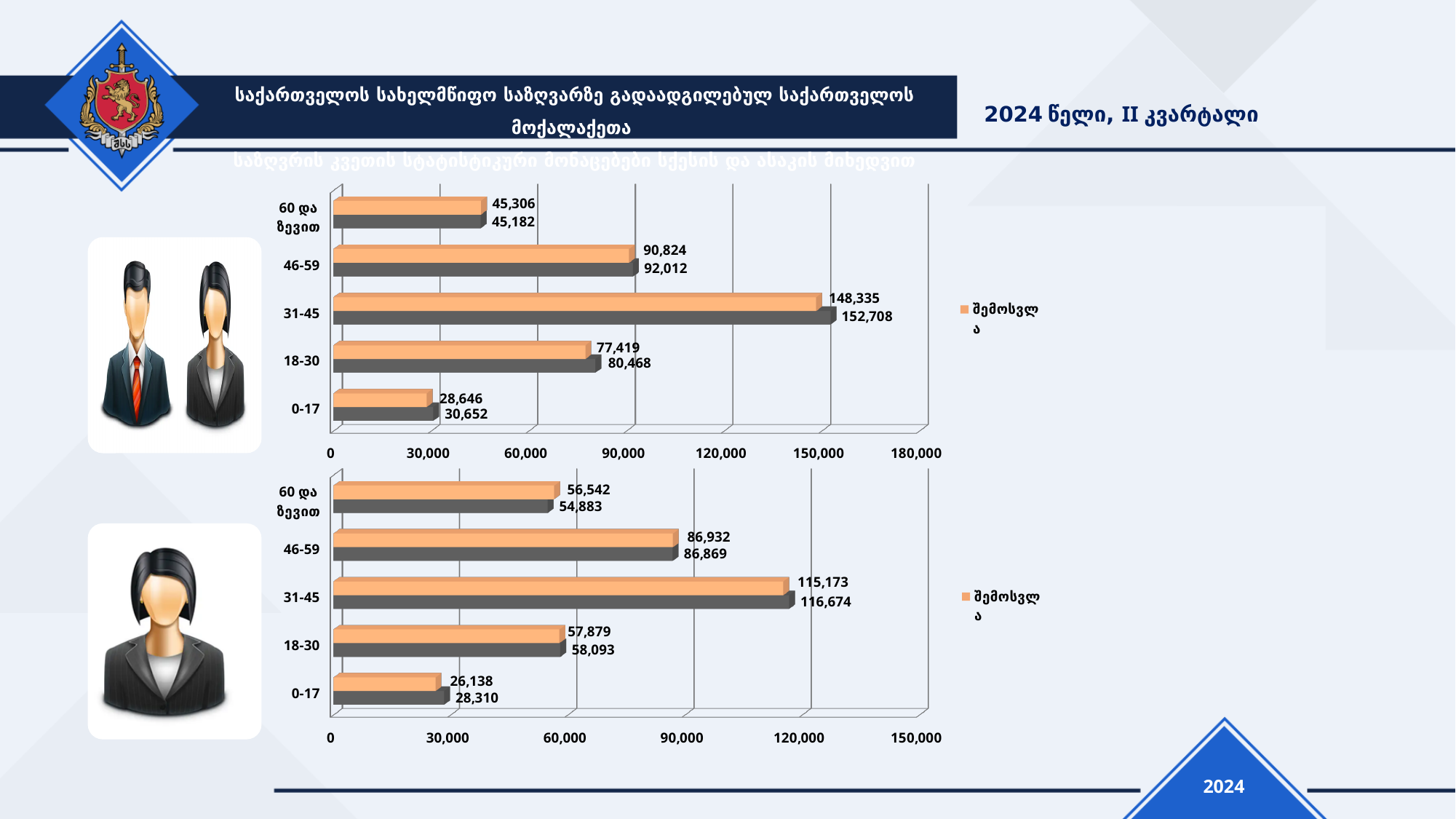
What type of chart is the bottom chart? bar chart In the bottom chart, for the '60 და ზევით' age group, which is larger: the orange bar or the dark grey bar? the orange bar In the top chart, what is the value of the dark grey bar for the 0-17 age group? 30,652 In the bottom chart, what is the value of the orange bar for the '60 და ზევით' age group? 56,542 In the top chart, what is the value of the orange bar for the 31-45 age group? 148,335 In the top chart, which age group has the highest orange bar value? 31-45 In the bottom chart, what is the difference between the dark grey and orange values for the 0-17 age group? 2,172 How many age-group categories are shown in the top chart? 5 In the bottom chart, what is the value of the dark grey bar for the 18-30 age group? 58,093 In the bottom chart, which age group has the lowest dark grey bar value? 0-17 In the top chart, for the 46-59 age group, which is larger: the orange bar or the dark grey bar? the dark grey bar In the top chart, what is the difference between the dark grey and orange values for the 31-45 age group? 4,373